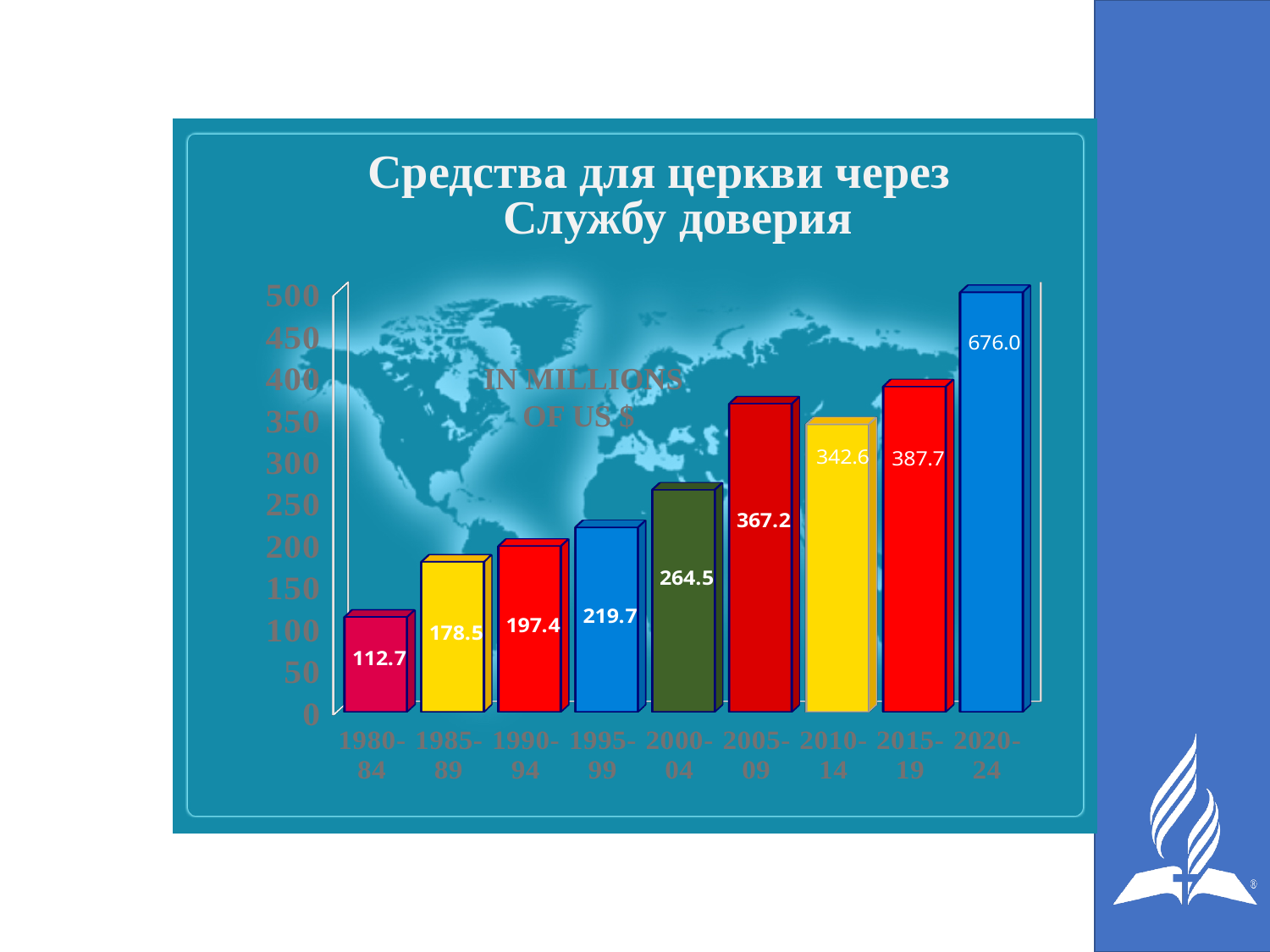
What kind of chart is shown on the slide? Bar chart What is the value for 2005-09? 367.2 What is the value for 2010-14? 342.6 Which is larger, the value for 2005-09 or the value for 2010-14? 2005-09 Which period has the highest value? 2020-24 What is the title of the chart? Средства для церкви через Службу доверия What is the difference between the values for 2005-09 and 2010-14? 24.6 How many periods are shown on the x axis? 9 What is the difference between the values for 2020-24 and 2015-19? 288.3 What is the value for 1980-84? 112.7 Which period has the lowest value? 1980-84 What is the value for 2020-24? 676.0